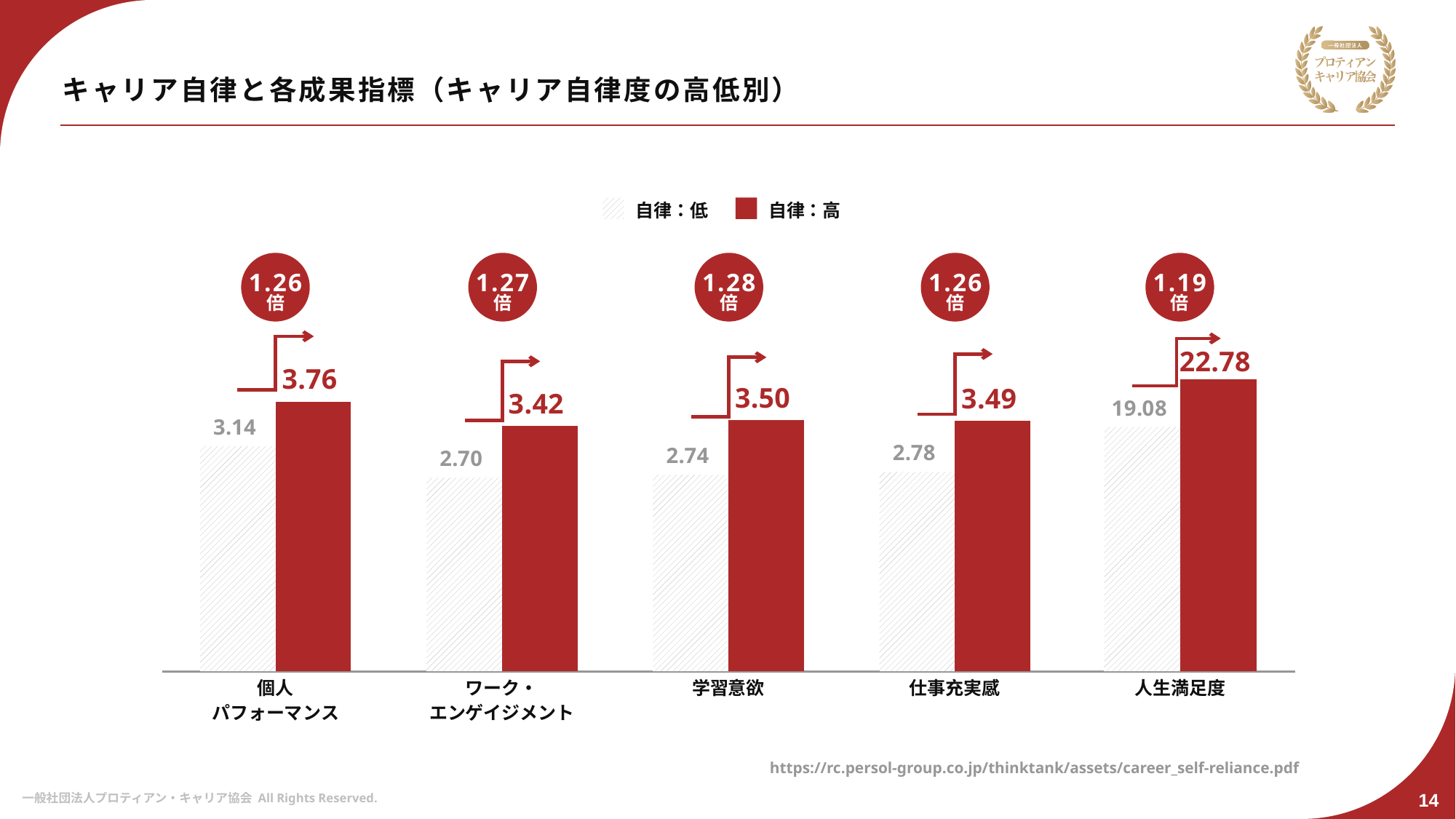
Which category has the lowest 自律：低 value? ワーク・エンゲイジメント What is the value for 自律：低 in the 学習意欲 category? 2.74 Which is larger in the 仕事充実感 category, the 自律：高 value or the 自律：低 value? 自律：高 How many series does the legend list? 2 Which category has the highest 自律：高 value? 人生満足度 What ratio (倍) is shown above the 学習意欲 category? 1.28倍 What type of chart is shown on the slide? bar chart Which category shows the smallest ratio (倍) between 自律：高 and 自律：低? 人生満足度 What is the value for 自律：高 in the 個人パフォーマンス category? 3.76 What is the value for 自律：低 in the 人生満足度 category? 19.08 What is the difference between the 自律：高 and 自律：低 values for 人生満足度? 3.70 How many categories are shown on the x axis of the chart? 5